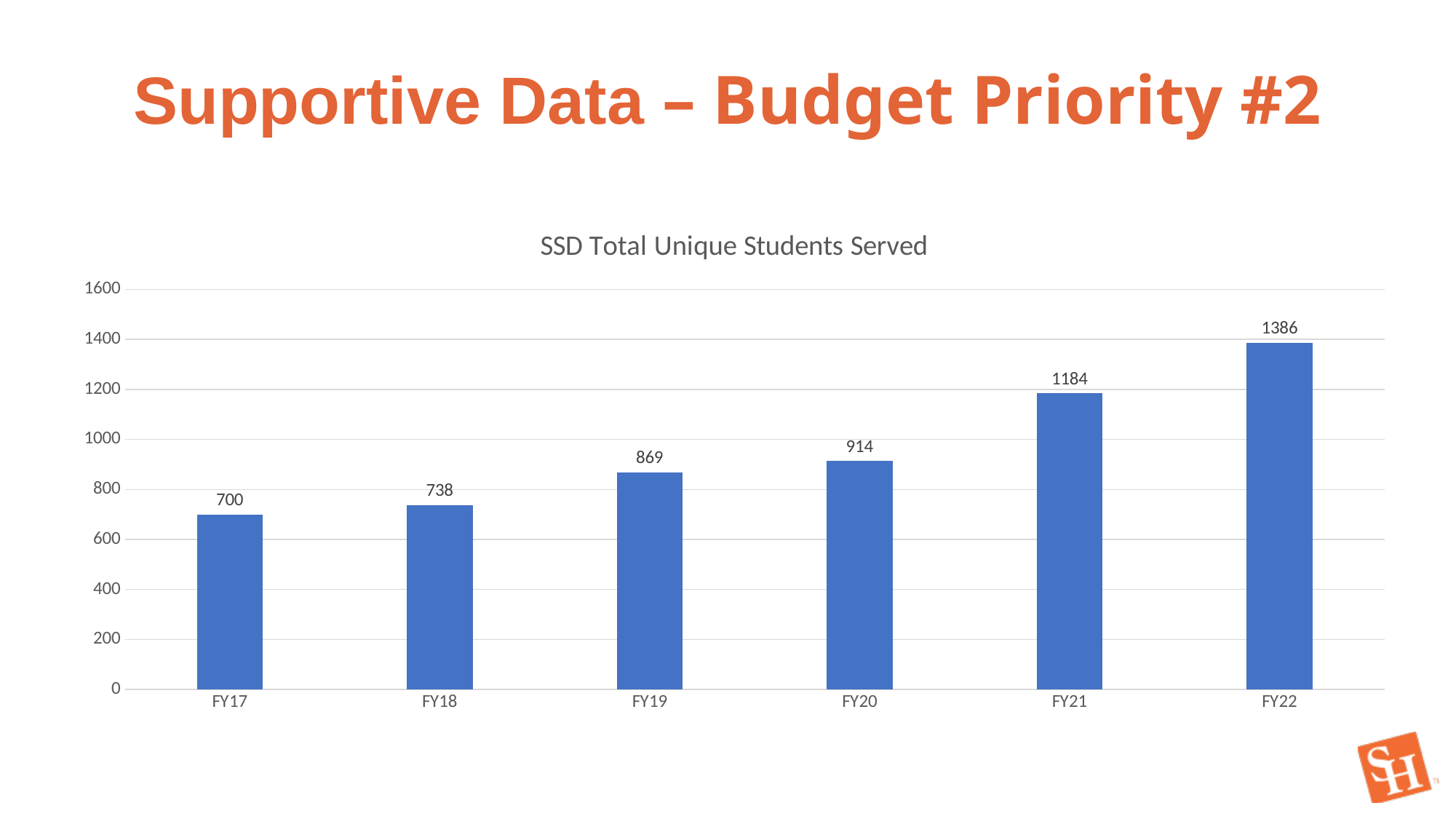
What is the value for FY19 in the SSD Total Unique Students Served chart? 869 How many unique students were served in FY22? 1386 What is the difference between the FY22 and FY21 values? 202 Is the value for FY21 greater or less than 1000? greater What is the value shown for FY17? 700 How many fiscal years are shown on the x axis of the chart? 6 Do the values rise or fall from FY17 to FY22? rise Which fiscal year has the lowest number of unique students served? FY17 Which fiscal year has the highest number of unique students served? FY22 Which is larger, the value for FY20 or the value for FY19? FY20 What kind of chart is shown on the slide? bar chart What is the difference between the FY18 and FY17 values? 38